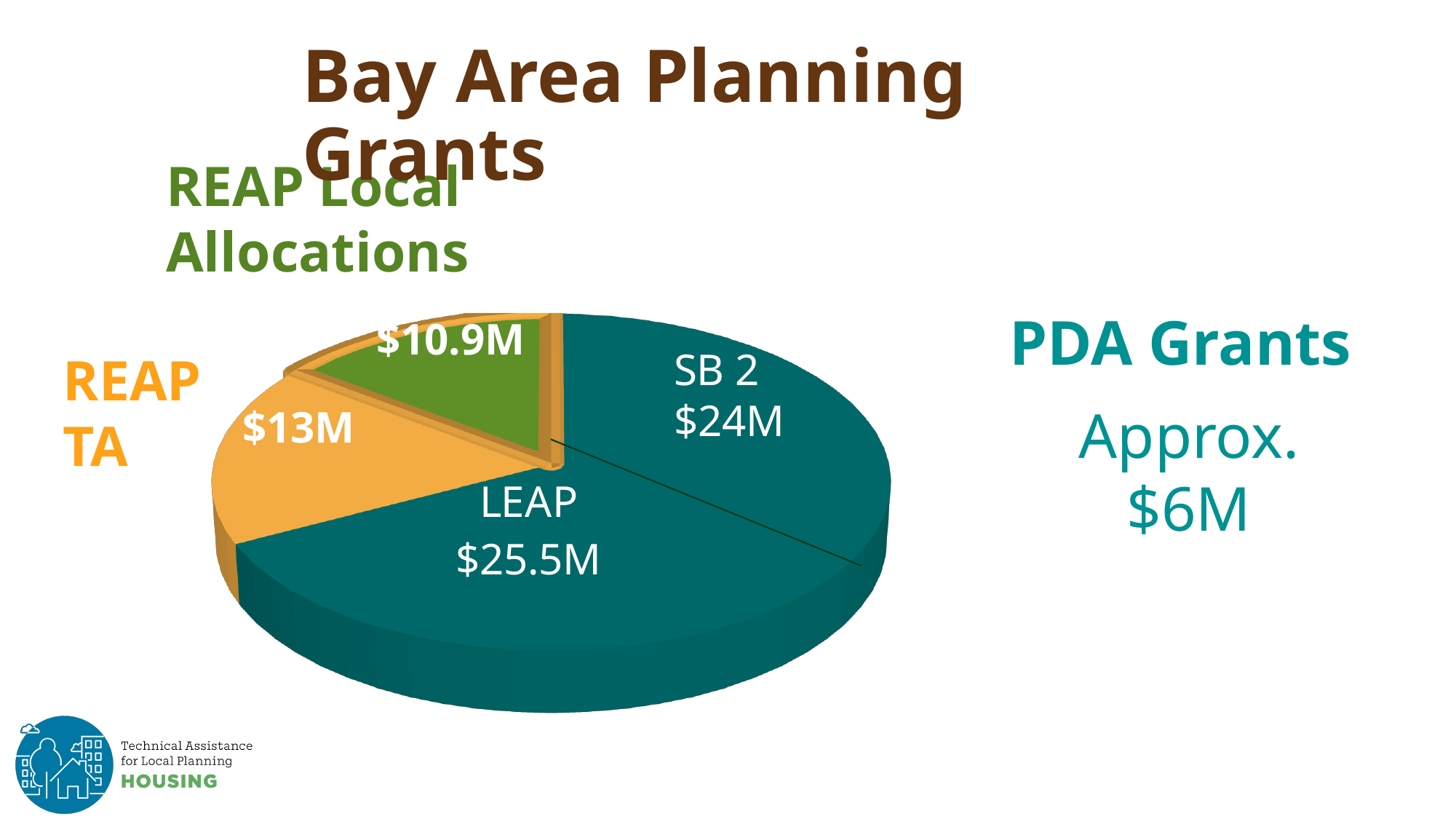
What is the value of the LEAP slice? $25.5M Which is larger, the SB 2 slice or the LEAP slice? LEAP What is the value of the REAP Local Allocations slice? $10.9M How many slices does the pie chart have? 4 What is the difference between the LEAP and SB 2 values? $1.5M What is the value of the SB 2 slice? $24M What is the value of the REAP TA slice? $13M What is the difference between the REAP TA and REAP Local Allocations values? $2.1M What is the title of the chart on the slide? Bay Area Planning Grants Which slice of the pie chart has the largest value? LEAP Which slice of the pie chart has the smallest value? REAP Local Allocations What type of chart is shown on the slide? Pie chart